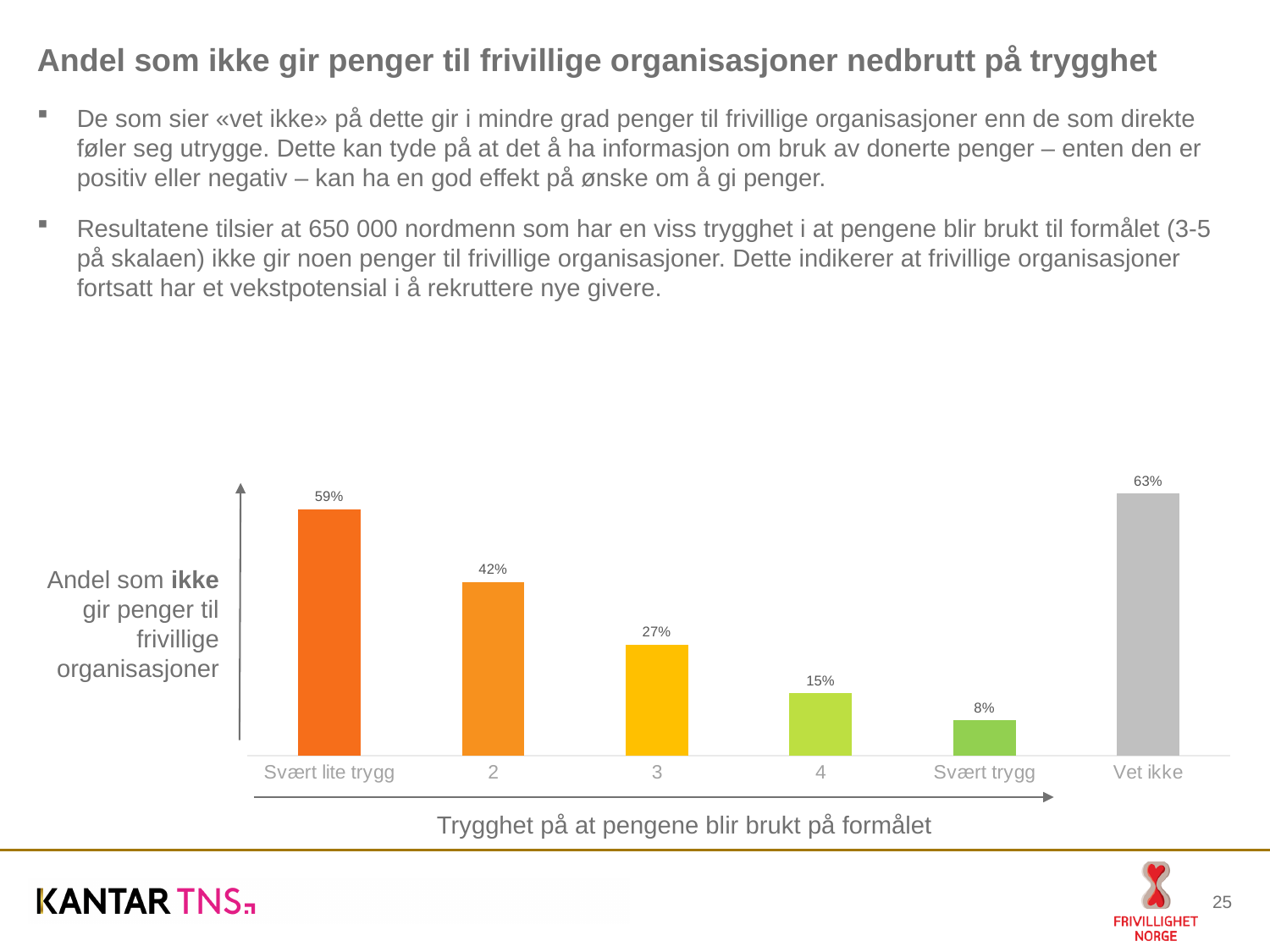
What is the value for "Vet ikke"? 63% Which category has the lowest value? Svært trygg Which category has the highest value? Vet ikke What is the x-axis title of the chart? Trygghet på at pengene blir brukt på formålet What is the difference between the values for "2" and "4"? 27% What is the value for "Svært trygg"? 8% How many categories are shown on the x axis? 6 What kind of chart is shown? Bar chart What is the value for category "3"? 27% What is the difference between the values for "Svært lite trygg" and "Svært trygg"? 51% What is the value for "Svært lite trygg"? 59% Which is larger, the value for "Vet ikke" or the value for "Svært lite trygg"? Vet ikke